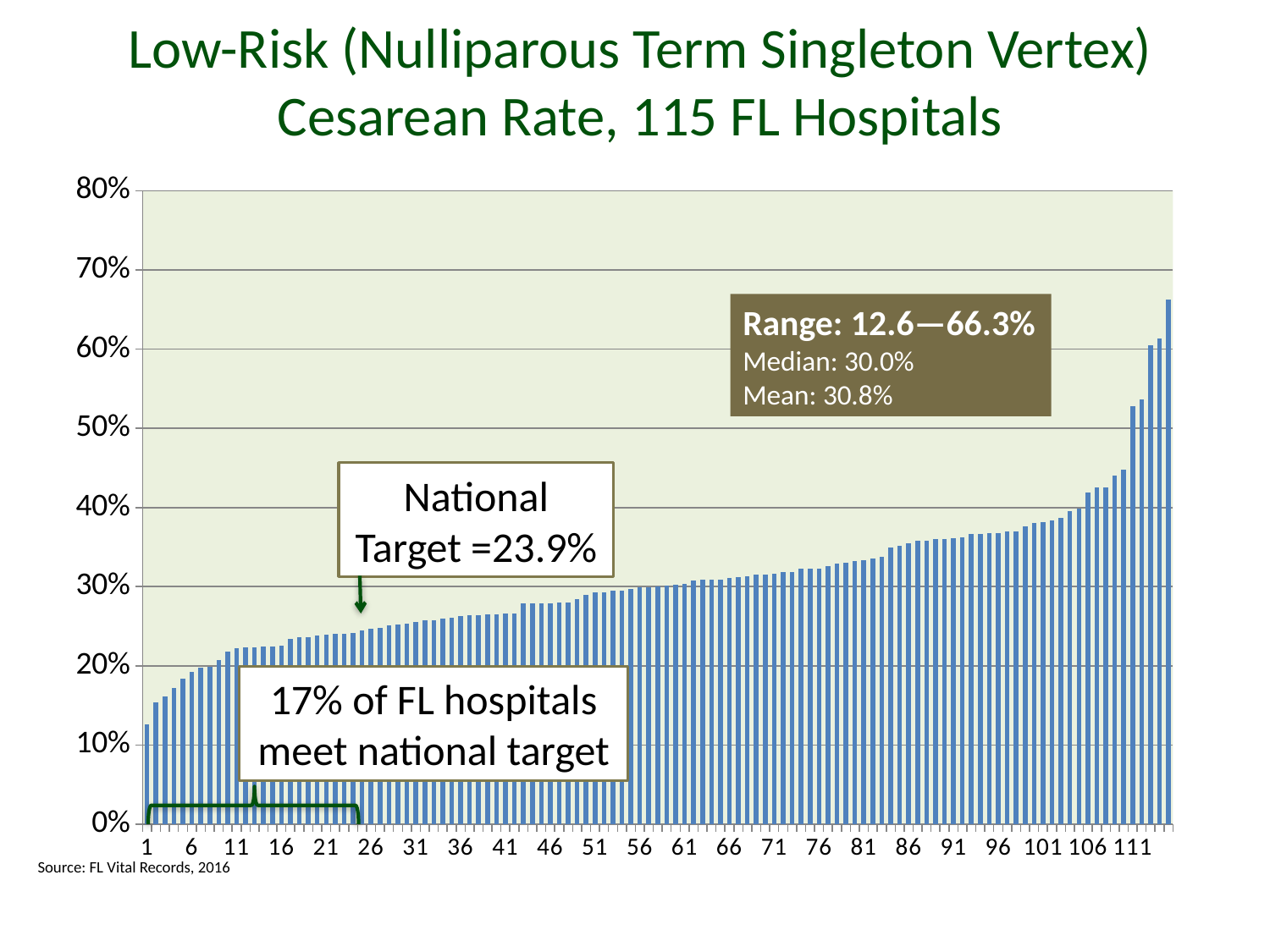
Is the value for hospital 100 greater or less than 30%? greater What is the national target cesarean rate shown on the chart? 23.9% What kind of chart is shown on the slide? bar chart What source is cited for the chart's data? FL Vital Records, 2016 What percentage of FL hospitals meet the national target, according to the chart? 17% What is the mean cesarean rate stated on the chart? 30.8% What is the lowest cesarean rate shown in the chart's range box? 12.6% What is the highest cesarean rate shown in the chart's range box? 66.3% Is the value for hospital 20 greater or less than 30%? less How many Florida hospitals are represented in the chart? 115 Do the bar values rise or fall moving from left to right along the x axis? rise What is the median cesarean rate stated on the chart? 30.0%